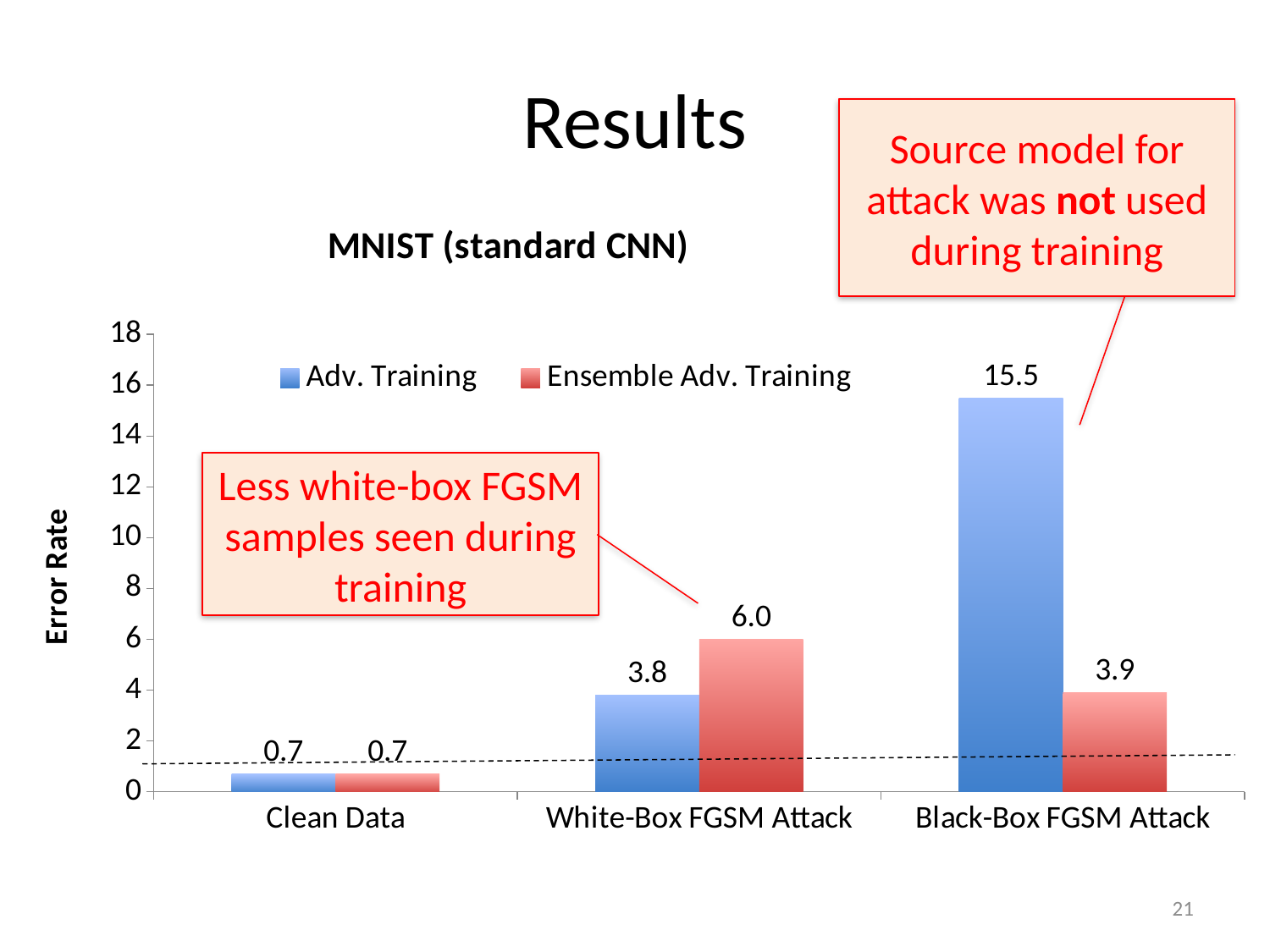
What kind of chart is shown on the slide? Bar chart What is the error rate for Adv. Training under the Black-Box FGSM Attack? 15.5 Which category has the highest error rate for Adv. Training? Black-Box FGSM Attack How many series does the legend list? 2 How many categories are shown on the x axis? 3 What is the title of the chart? MNIST (standard CNN) What is the error rate for Ensemble Adv. Training under the White-Box FGSM Attack? 6.0 Which category has the lowest error rate for Ensemble Adv. Training? Clean Data Under the White-Box FGSM Attack, which series has the higher error rate? Ensemble Adv. Training Is the Adv. Training error rate under the Black-Box FGSM Attack greater or less than 14? greater What is the error rate for Ensemble Adv. Training on Clean Data? 0.7 What is the difference between the Adv. Training and Ensemble Adv. Training error rates under the Black-Box FGSM Attack? 11.6